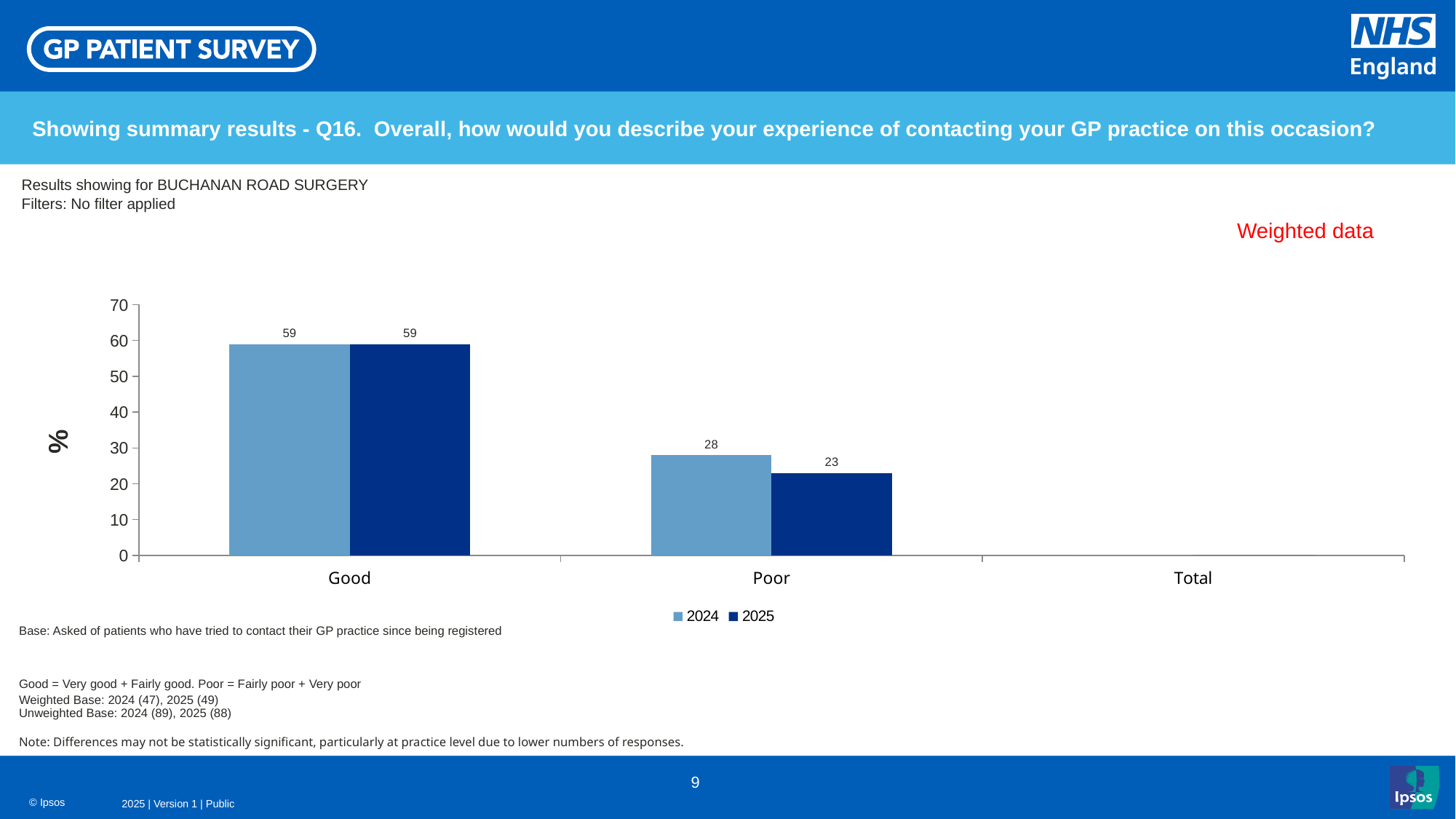
What is the label on the vertical axis of the chart? % What is the value for Good in 2024? 59 What is the difference between the Good and Poor values for 2025? 36 What is the value for Poor in 2024? 28 What are the two entries in the chart legend? 2024 and 2025 What is the difference between the 2024 and 2025 values for Poor? 5 For Poor, which year has the larger value, 2024 or 2025? 2024 Is the value for Good in 2025 greater or less than 50? greater What kind of chart is shown on the slide? bar chart How many series does the legend list? 2 Which category has the highest value for the 2025 series? Good What is the value for Poor in 2025? 23